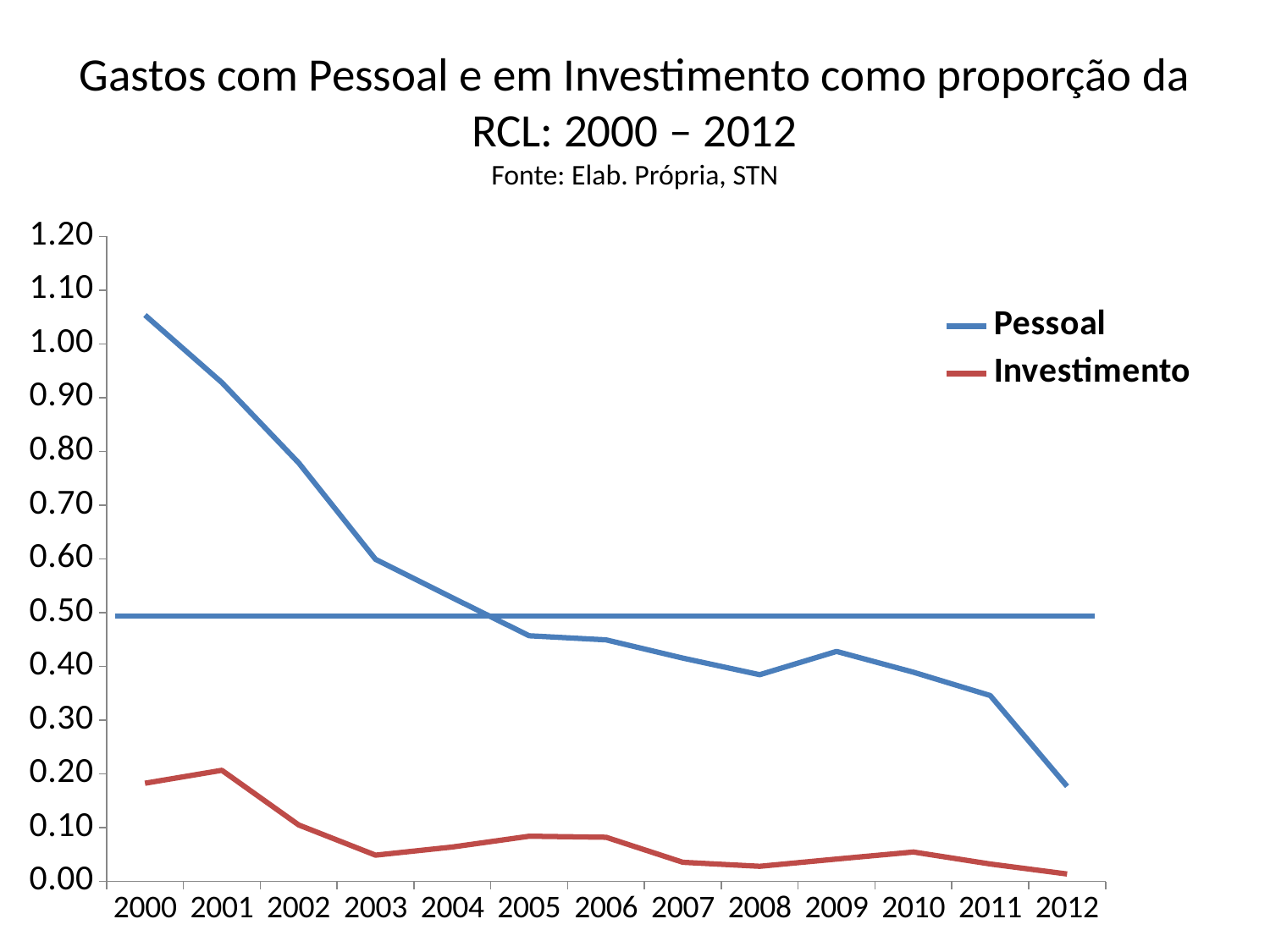
Which is larger, the Pessoal value in 2008 or in 2009? 2009 Is the value for Investimento in 2012 greater or less than 0.10? less Is the value for Pessoal in 2012 greater or less than 0.20? less How many years are plotted along the x axis? 13 Does the Pessoal series generally rise or fall from 2000 to 2012? fall Is the value for Pessoal in 2000 greater or less than 1.00? greater How many series does the legend list? 2 Which colour represents the Investimento series in the legend? red In which year is the Pessoal series at its highest? 2000 What kind of chart is shown on the slide? line chart In which year is the Investimento series at its highest? 2001 In which year is the Pessoal series at its lowest? 2012